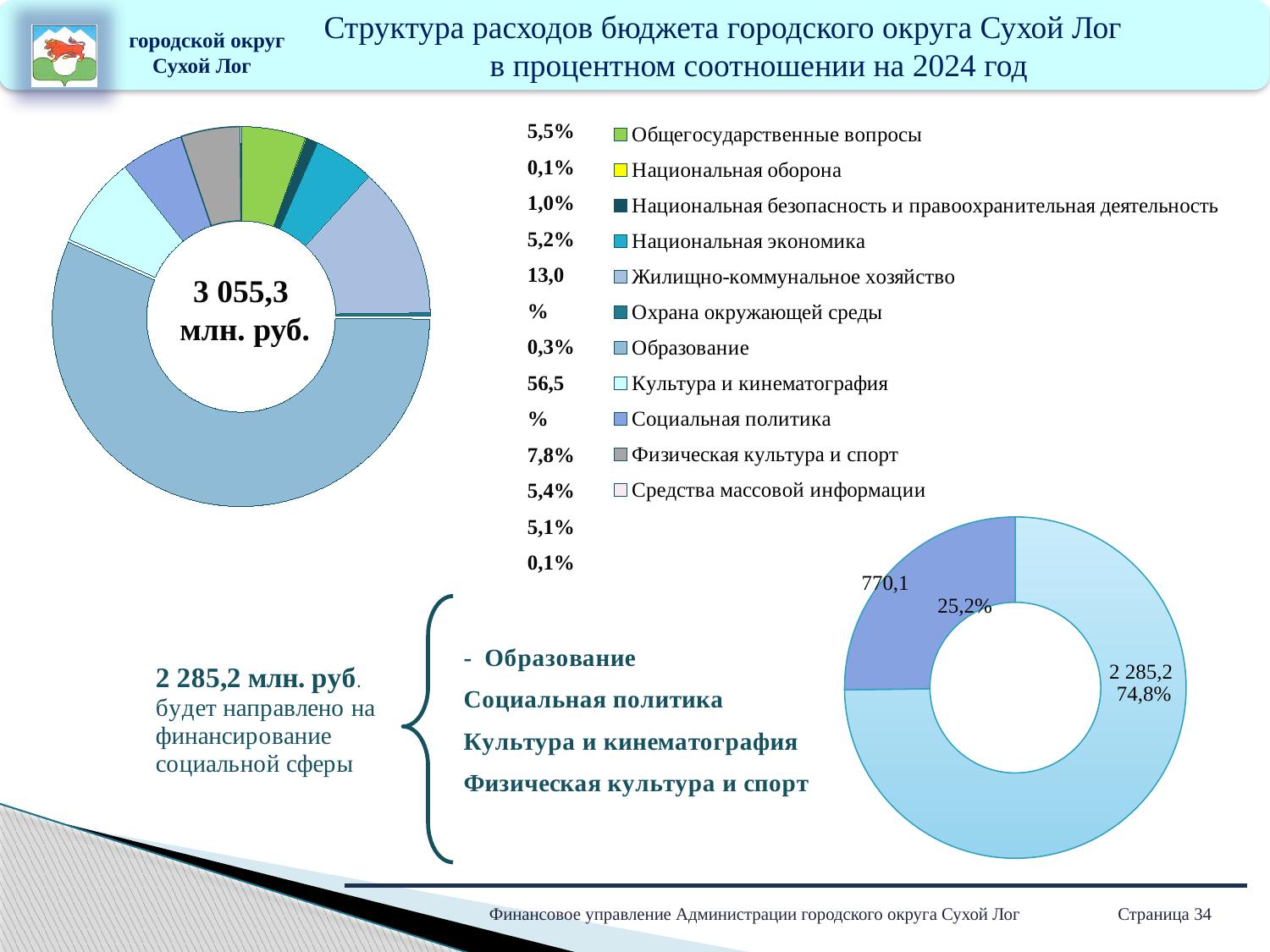
In the left donut chart, what total value is printed in the centre? 3 055,3 млн. руб. In the left donut chart, what percentage is shown for Образование? 56,5% In the left donut chart, what percentage is shown for Жилищно-коммунальное хозяйство? 13,0% In the left donut chart, which category has the largest share? Образование In the bottom-right donut chart, what percentage is shown for the slice labelled 770,1? 25,2% How many slices does the bottom-right donut chart have? 2 In the left donut chart, what percentage is shown for Общегосударственные вопросы? 5,5% How many categories does the legend of the left donut chart list? 11 In the bottom-right donut chart, what percentage is shown for the slice labelled 2 285,2? 74,8% In the bottom-right donut chart, what is the difference between the two slice values, 2 285,2 and 770,1? 1 515,1 What kind of chart is the large chart on the left of the slide? Donut (pie) chart In the left donut chart, which is larger: the share for Образование or the share for Жилищно-коммунальное хозяйство? Образование